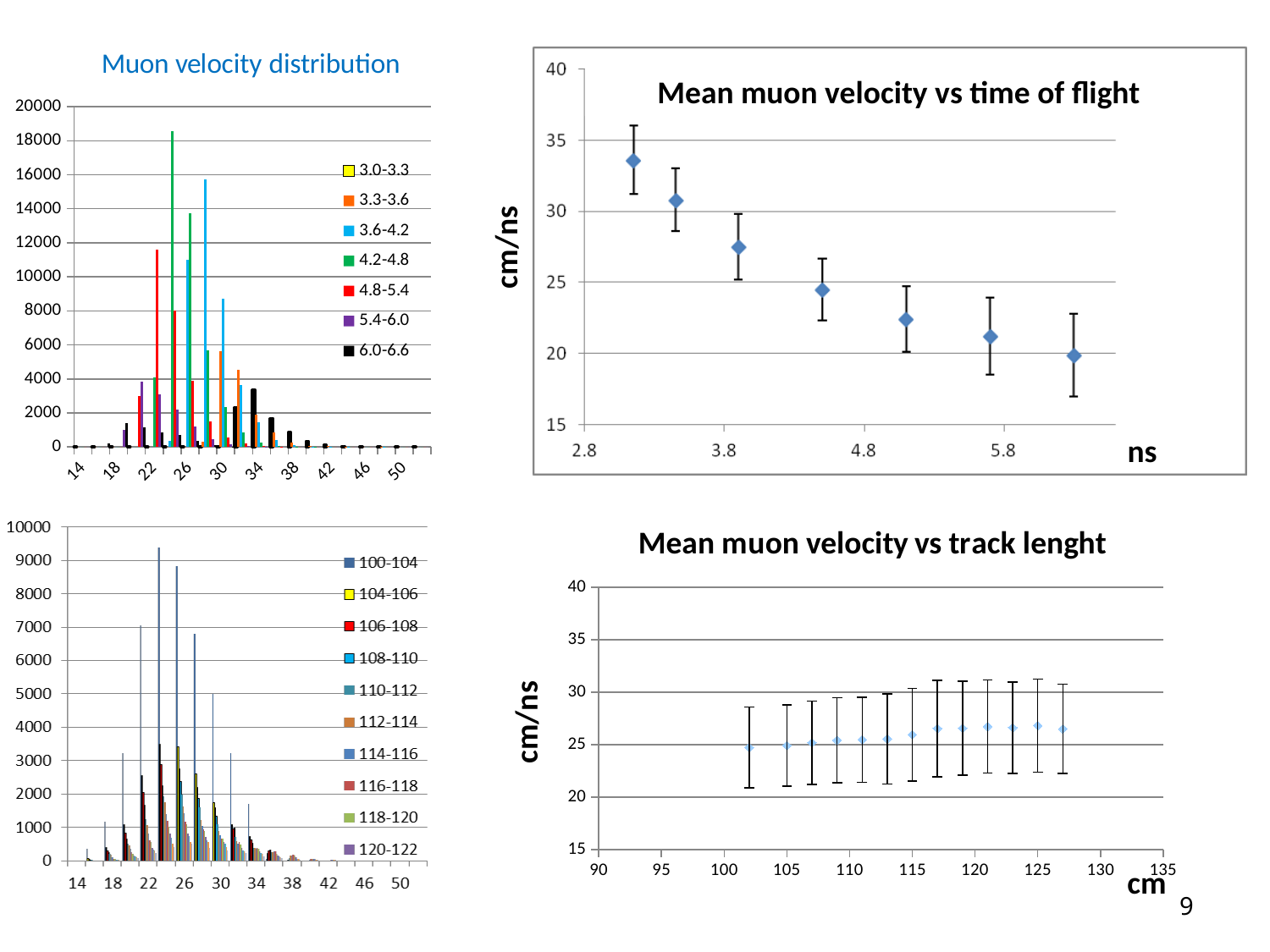
In the top-left 'Muon velocity distribution' chart, is the tallest bar greater or less than 16000? greater In the top-left 'Muon velocity distribution' chart, which series has the tallest bar? 4.2-4.8 What kind of chart is the top-left 'Muon velocity distribution' chart? bar chart In the 'Mean muon velocity vs time of flight' chart, do the values rise or fall as time of flight increases? fall How many data points are plotted in the 'Mean muon velocity vs time of flight' chart? 7 In the bottom-left bar chart, is the tallest bar greater or less than 9000? greater How many series does the legend of the bottom-left chart list? 10 In the 'Mean muon velocity vs time of flight' chart, which is larger: the leftmost point or the rightmost point? the leftmost point In the 'Mean muon velocity vs time of flight' chart, is the value of the first (leftmost) point greater or less than 30? greater What is the y-axis label of the 'Mean muon velocity vs track lenght' chart? cm/ns What is the title of the top-left chart? Muon velocity distribution How many series does the legend of the top-left chart list? 7